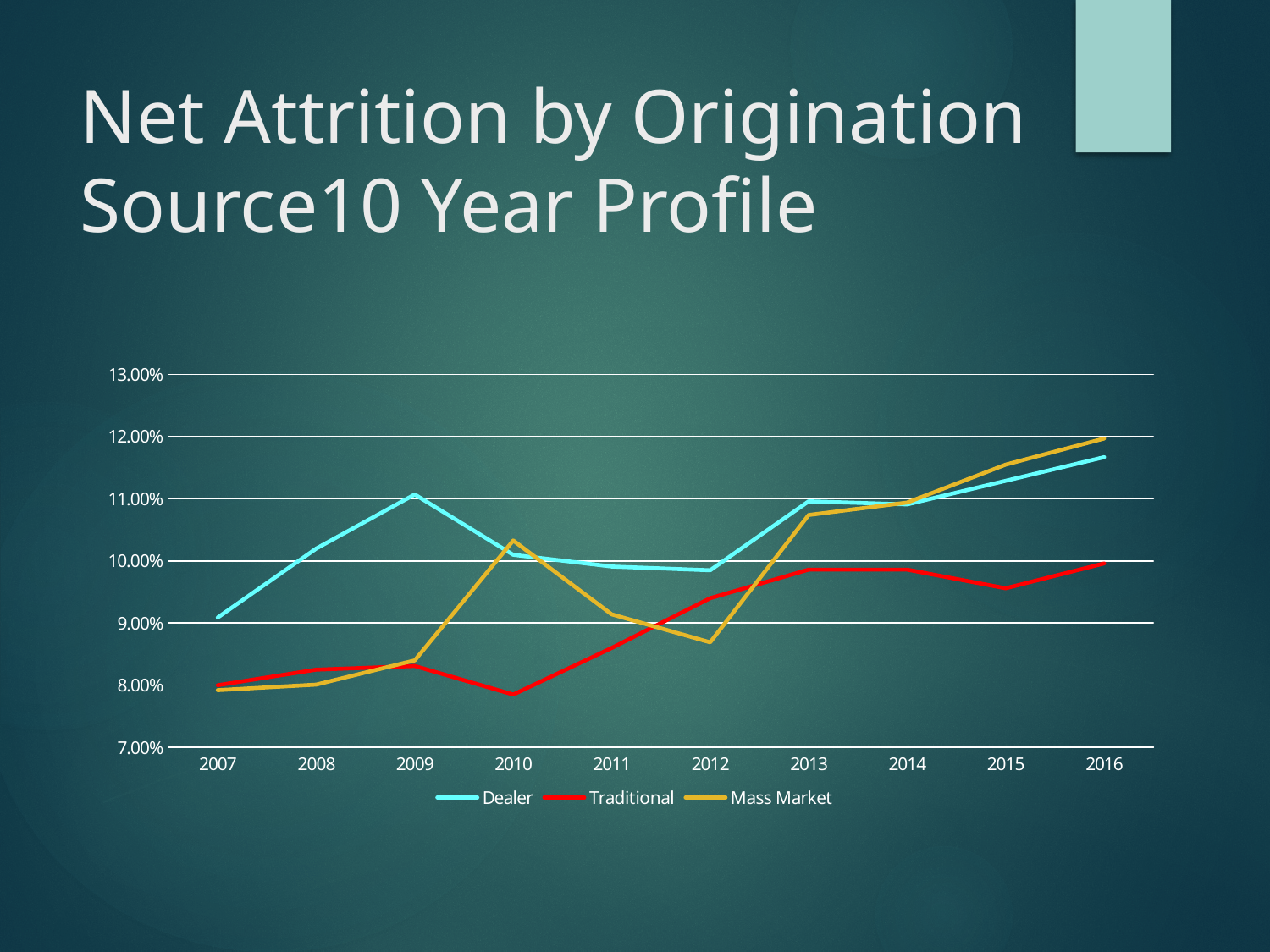
How many years are shown on the x axis? 10 Which series has the highest value in 2016? Mass Market What is the title of the slide? Net Attrition by Origination Source10 Year Profile What kind of chart is shown on the slide? line chart How many series does the legend list? 3 In which year is the Traditional series at its lowest? 2010 In 2010, which series has the larger value, Dealer or Traditional? Dealer Is the value for Mass Market in 2013 greater or less than 10.00%? greater Is the value for Mass Market in 2012 greater or less than 9.00%? less Does the Mass Market series rise or fall from 2013 to 2016? rise Which series has the lowest value in 2016? Traditional Is the value for Traditional in 2010 greater or less than 8.00%? less